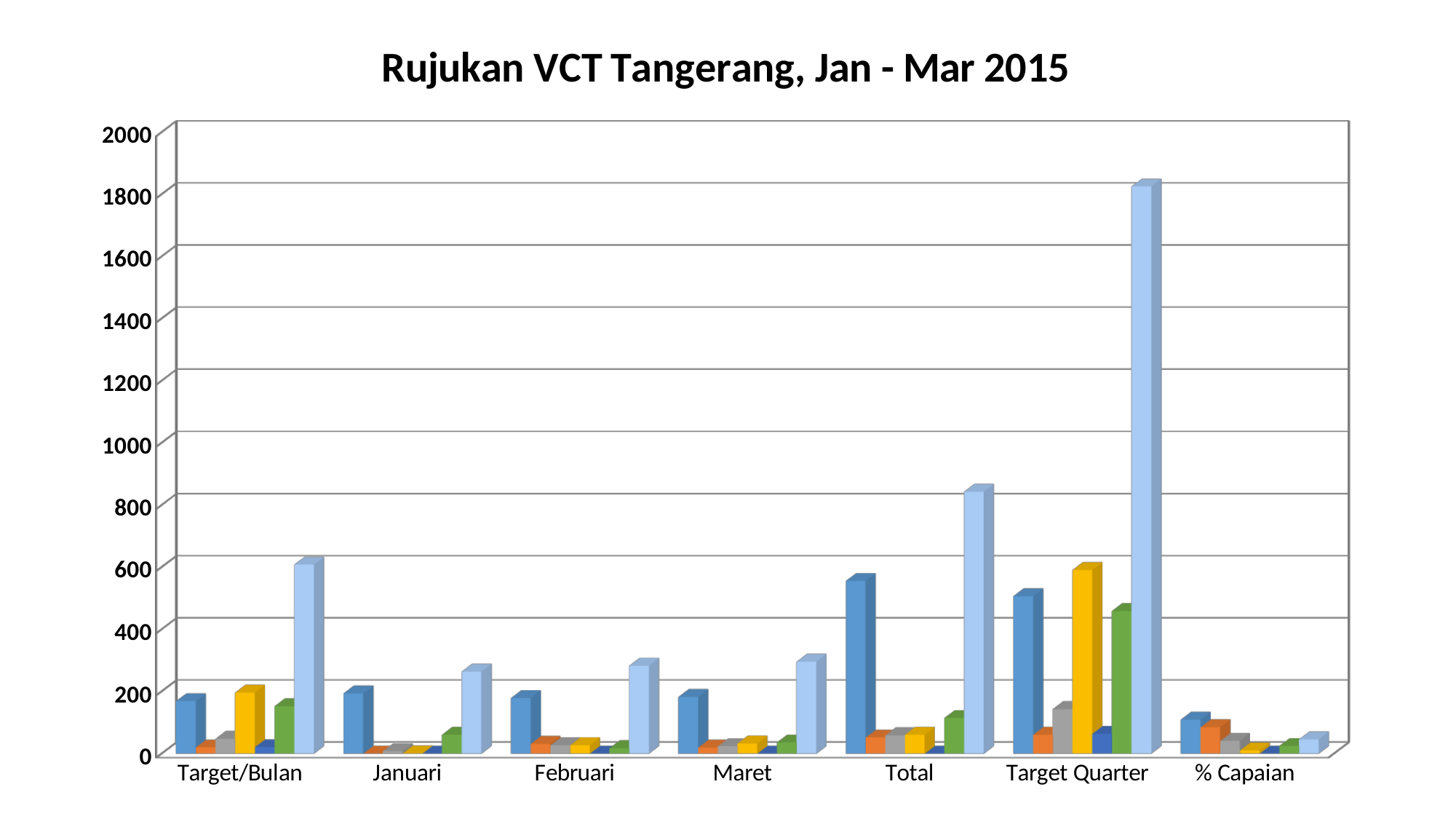
Which category contains the tallest bar in the chart? Target Quarter How many categories are shown along the x axis? 7 What is the highest value shown on the vertical axis? 2000 Is the tallest bar in the Januari category greater or less than 400? less What is the title of the chart? Rujukan VCT Tangerang, Jan - Mar 2015 Which category has the taller light blue bar, Target/Bulan or Januari? Target/Bulan Is the tallest bar in the Total category greater or less than 600? greater Which category has the taller light blue bar, Total or Target Quarter? Target Quarter Is the tallest bar in the Target Quarter category greater or less than 1600? greater What kind of chart is shown on the slide? bar chart